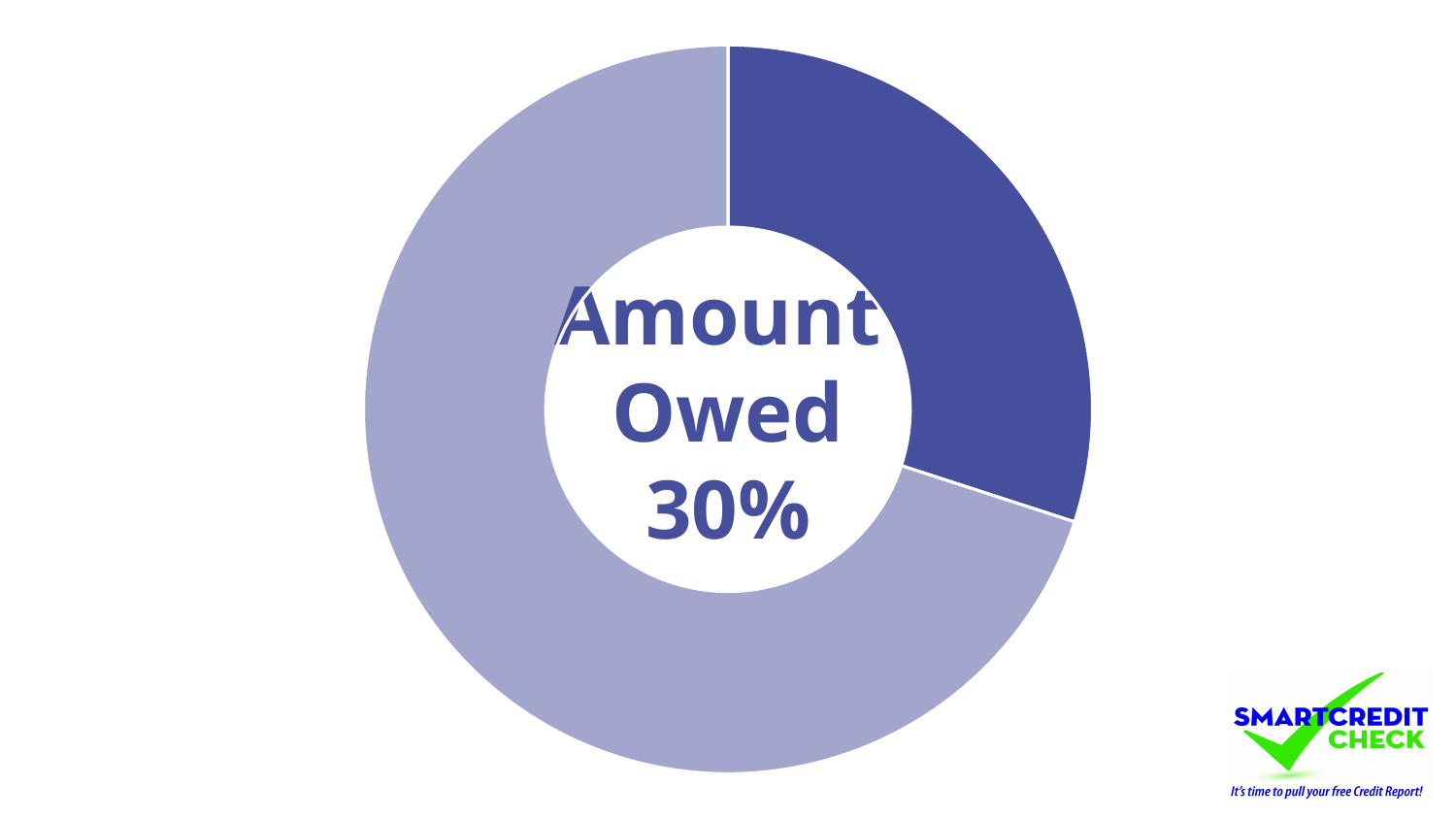
How many slices does the donut chart have? 2 What percentage is shown for Amount Owed in the chart? 30% What colour is the slice representing Amount Owed? dark blue Which slice is larger, the dark blue slice or the light blue slice? the light blue slice Which slice of the donut chart is the smallest? the dark blue (Amount Owed) slice What kind of chart is shown on the slide? donut (pie) chart What text is printed in the centre of the donut chart? Amount Owed 30% What share of the donut chart does the Amount Owed slice represent? 30%